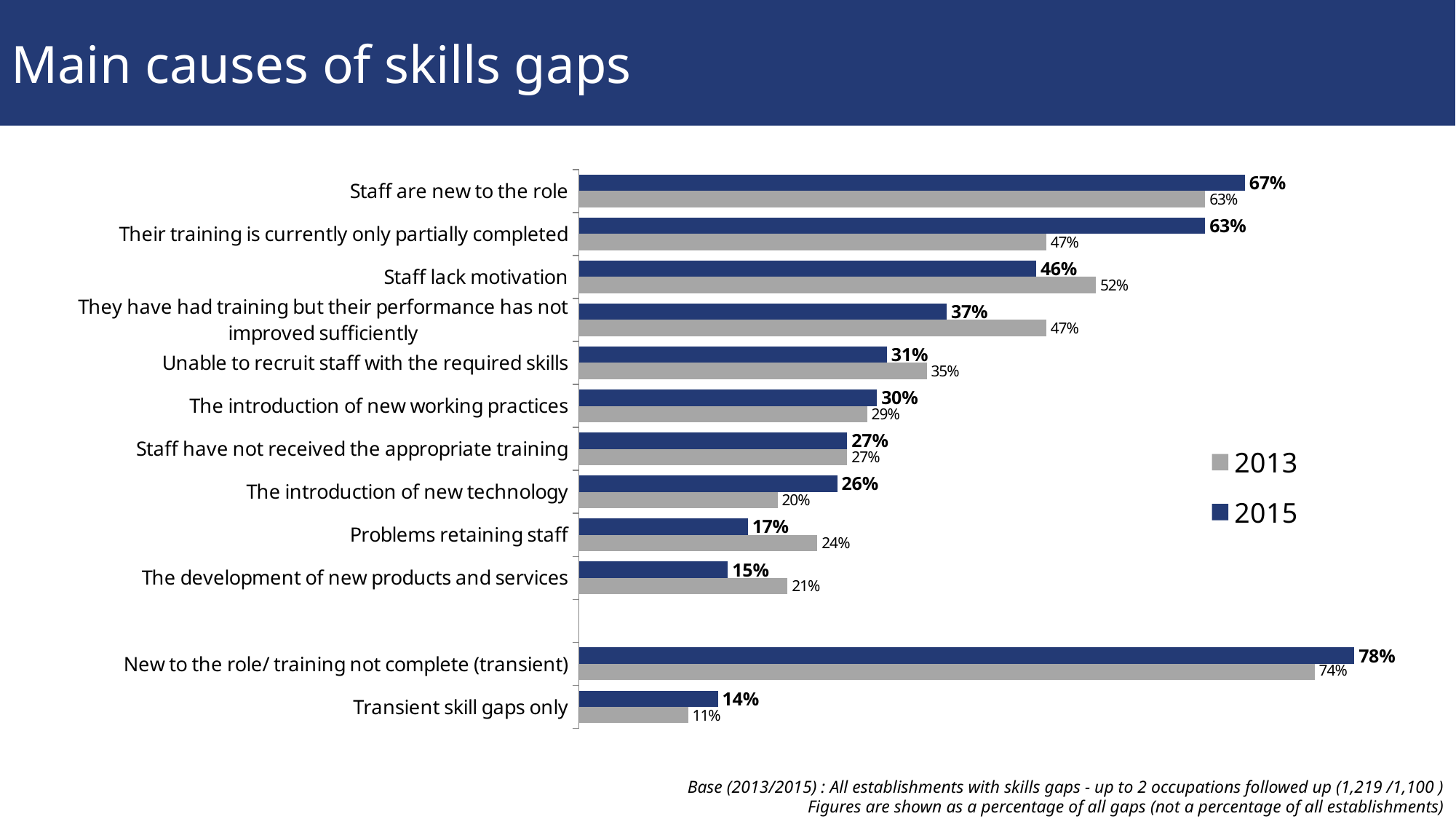
What is the 2013 value for 'Staff lack motivation'? 52% What is the 2015 value for 'Problems retaining staff'? 17% What is the difference between the 2015 and 2013 values for 'Their training is currently only partially completed'? 16% What is the 2015 value for 'Staff are new to the role'? 67% Which category has the lowest 2013 value? Transient skill gaps only How many series does the legend list? 2 What is the 2013 value for 'Their training is currently only partially completed'? 47% Which category has the highest 2015 value? New to the role/ training not complete (transient) How many categories are shown on the chart? 12 What kind of chart is shown on the slide? Bar chart For 'Staff lack motivation', which year has the larger value, 2013 or 2015? 2013 Which colour represents the 2015 series in the legend? Dark blue